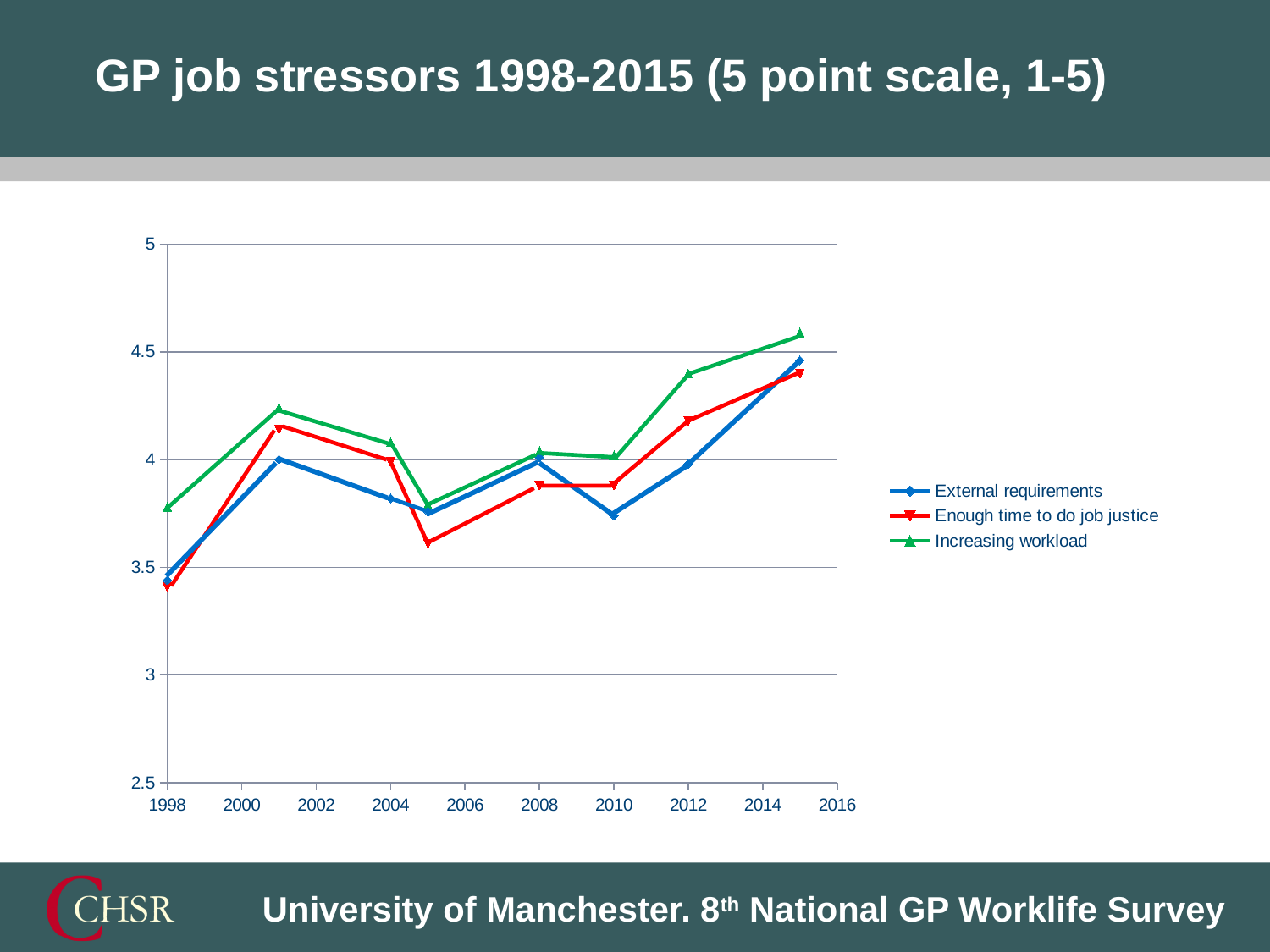
In 2005, which is lower: Enough time to do job justice or External requirements? Enough time to do job justice Is the value for Enough time to do job justice in 2012 greater or less than 4? greater In 2012, which is higher: Increasing workload or External requirements? Increasing workload What kind of chart is shown on the slide? Line chart Which series has the highest value in 2015? Increasing workload What is the title of the chart? GP job stressors 1998-2015 (5 point scale, 1-5) Is the value for External requirements in 2010 greater or less than 4? less Overall, do the values for Increasing workload rise or fall from 1998 to 2015? Rise Is the value for Increasing workload in 2015 greater or less than 4.5? greater How many series does the legend list? 3 Which series is plotted with the green line? Increasing workload